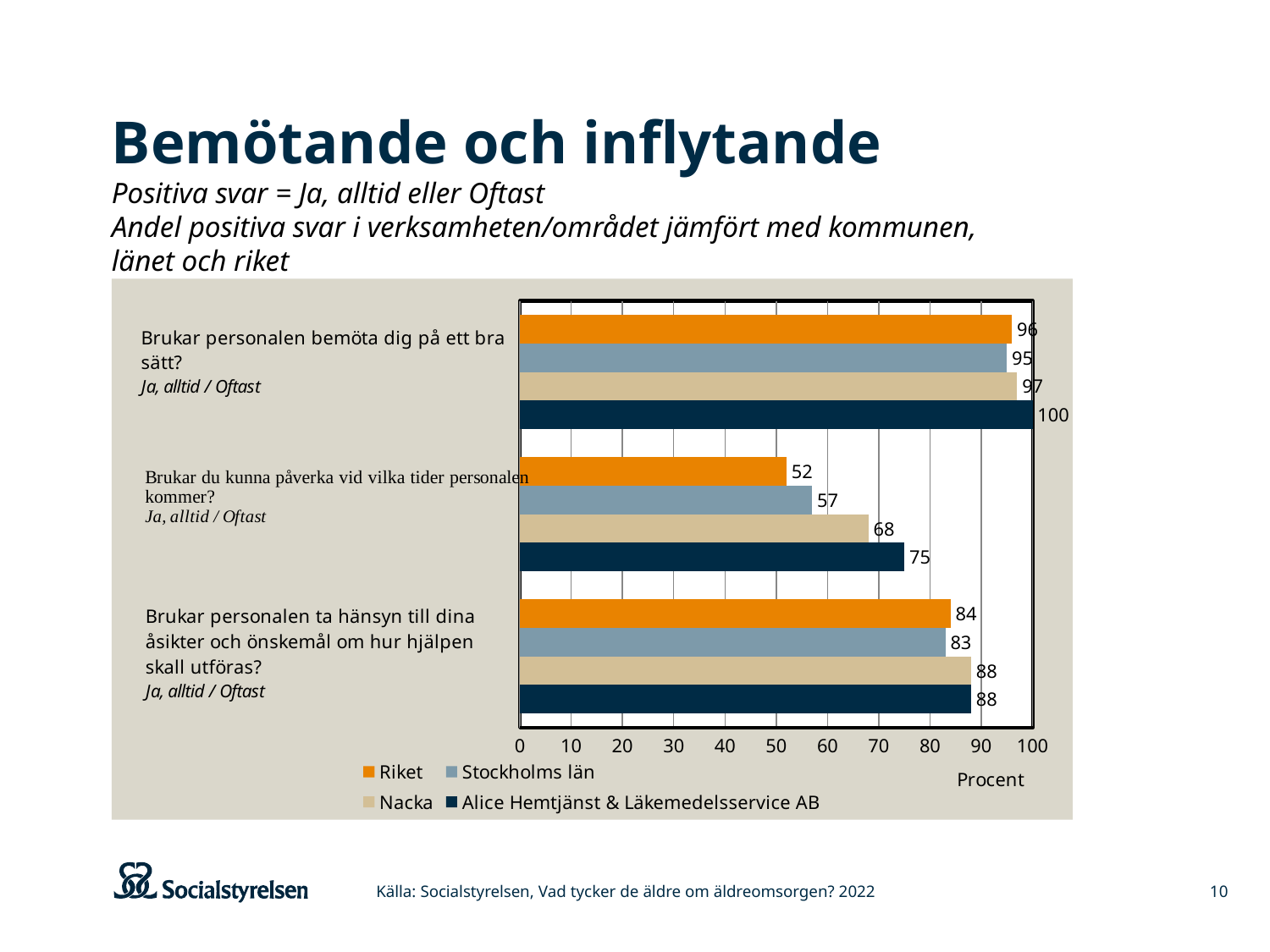
What is the value for Stockholms län on the question "Brukar du kunna påverka vid vilka tider personalen kommer?"? 57 What unit label is shown on the horizontal axis of the chart? Procent Which is larger on the question "Brukar personalen ta hänsyn till dina åsikter och önskemål om hur hjälpen skall utföras?": the Riket value or the Nacka value? Nacka Is the Nacka value on the question "Brukar du kunna påverka vid vilka tider personalen kommer?" greater or less than 60? greater What kind of chart is shown on the slide? Bar chart Which series has the highest value on the question "Brukar du kunna påverka vid vilka tider personalen kommer?"? Alice Hemtjänst & Läkemedelsservice AB What is the value for Alice Hemtjänst & Läkemedelsservice AB on the question "Brukar personalen bemöta dig på ett bra sätt?"? 100 Which series has the lowest value on the question "Brukar personalen bemöta dig på ett bra sätt?"? Stockholms län What is the value for Nacka on the question "Brukar personalen ta hänsyn till dina åsikter och önskemål om hur hjälpen skall utföras?"? 88 What is the difference between the Alice Hemtjänst & Läkemedelsservice AB value and the Riket value on the question "Brukar du kunna påverka vid vilka tider personalen kommer?"? 23 What is the value for Riket on the question "Brukar du kunna påverka vid vilka tider personalen kommer?"? 52 How many series does the legend list? 4